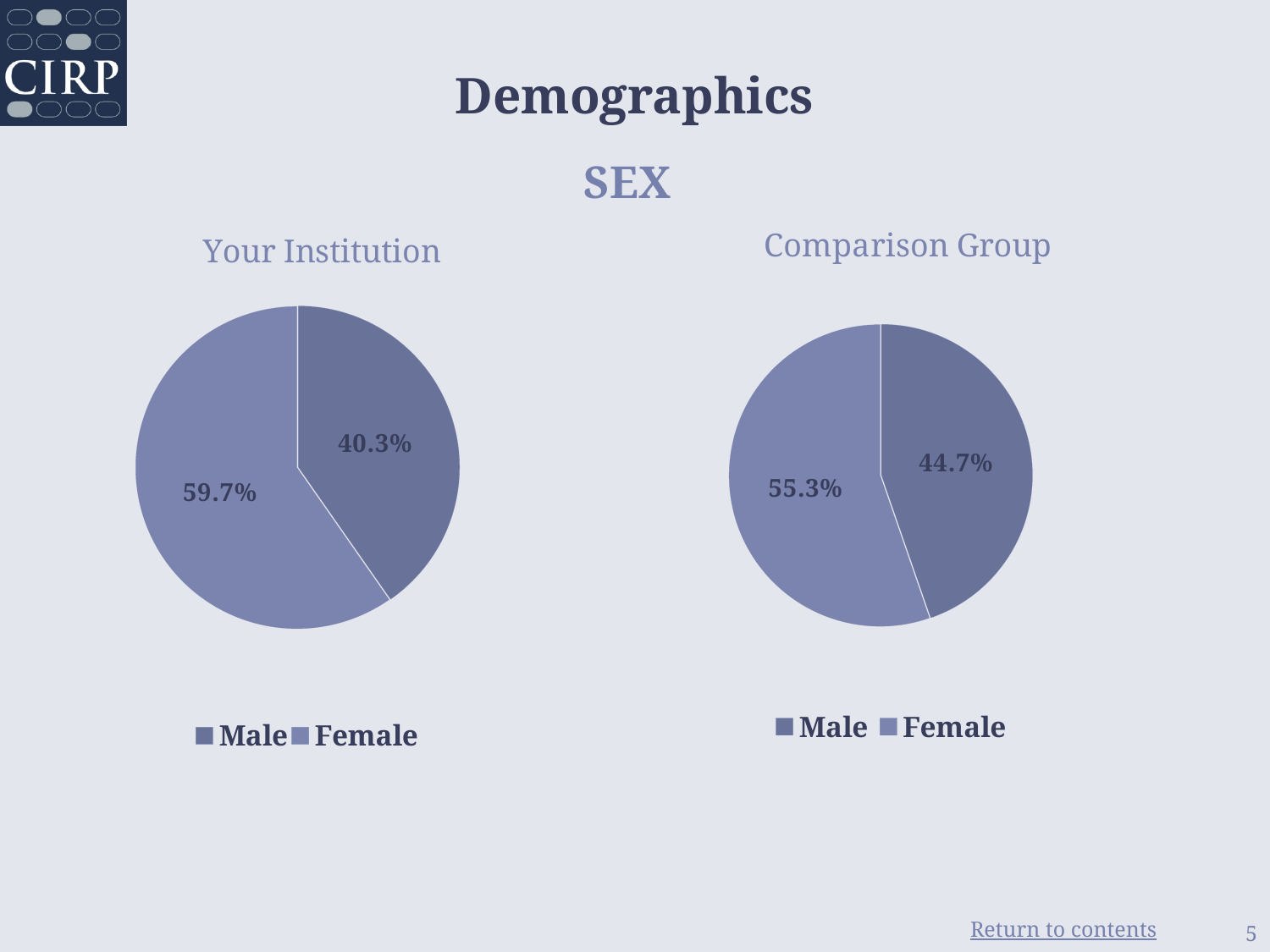
In the Your Institution pie chart, which category has the largest share? Female Is the Male share larger in the Your Institution chart or the Comparison Group chart? Comparison Group How many slices does the Your Institution pie chart have? 2 In the Comparison Group pie chart, what percentage is Female? 55.3% In the Your Institution pie chart, what is the difference between the Female and Male shares? 19.4% What entries does the legend of the Your Institution chart list? Male, Female In the Comparison Group pie chart, what is the difference between the Female and Male shares? 10.6% In the Comparison Group pie chart, which category has the smallest share? Male In the Your Institution pie chart, what percentage is Female? 59.7% What kind of chart is the Comparison Group chart? Pie chart In the Your Institution pie chart, what percentage is Male? 40.3% In the Comparison Group pie chart, what percentage is Male? 44.7%